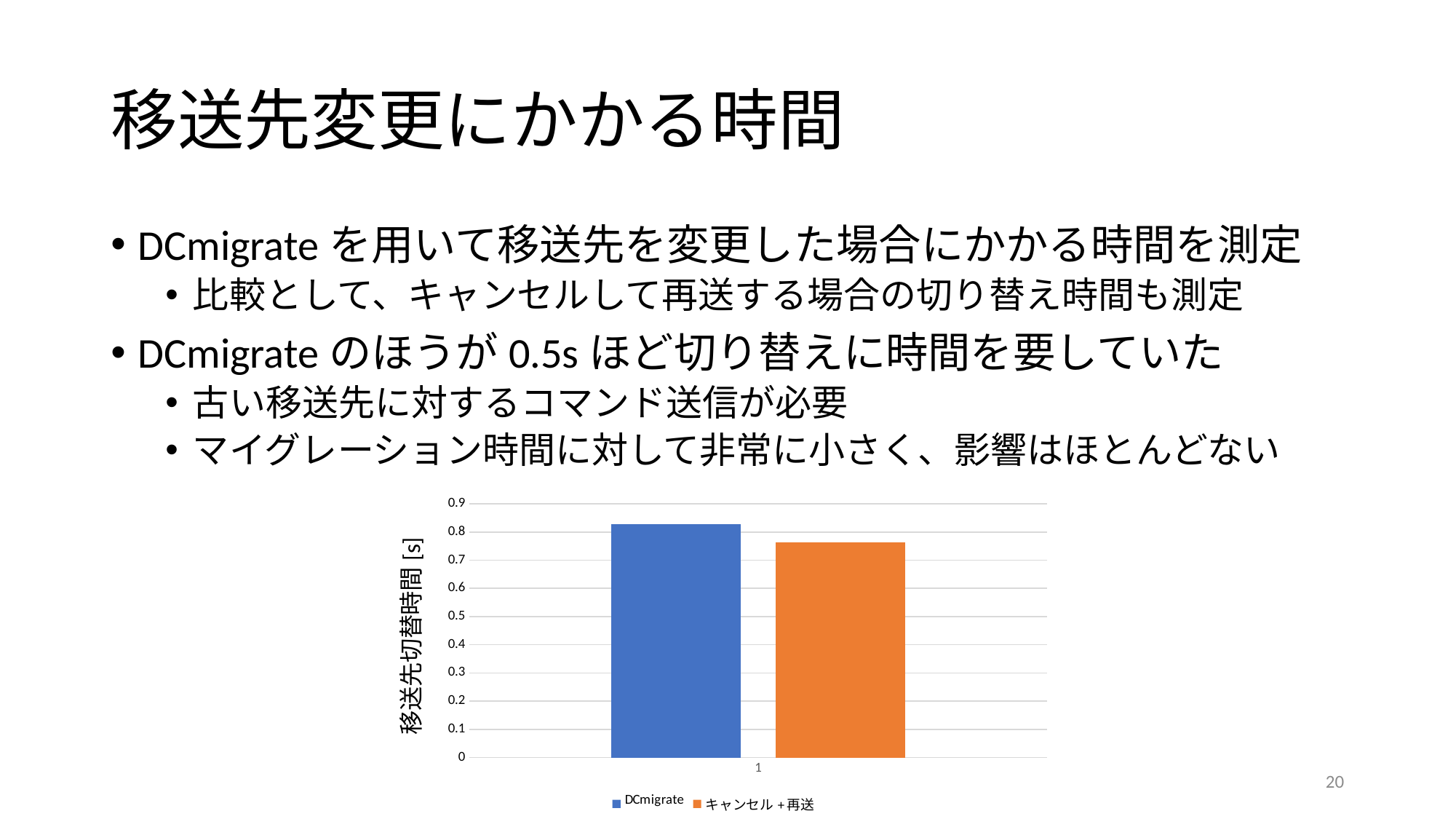
Which series has the taller bar, DCmigrate or キャンセル + 再送? DCmigrate How many series does the chart legend list? 2 Which series has the lowest value in the chart? キャンセル + 再送 How many categories are shown on the x axis of the chart? 1 What kind of chart is shown on the slide? bar chart What colour is the bar for the DCmigrate series? blue What is the label of the vertical axis of the chart? 移送先切替時間 [s] Is the value for DCmigrate greater or less than 0.8? greater Is the value for キャンセル + 再送 greater or less than 0.8? less Is the value for キャンセル + 再送 greater or less than 0.7? greater Which series has the highest value in the chart? DCmigrate